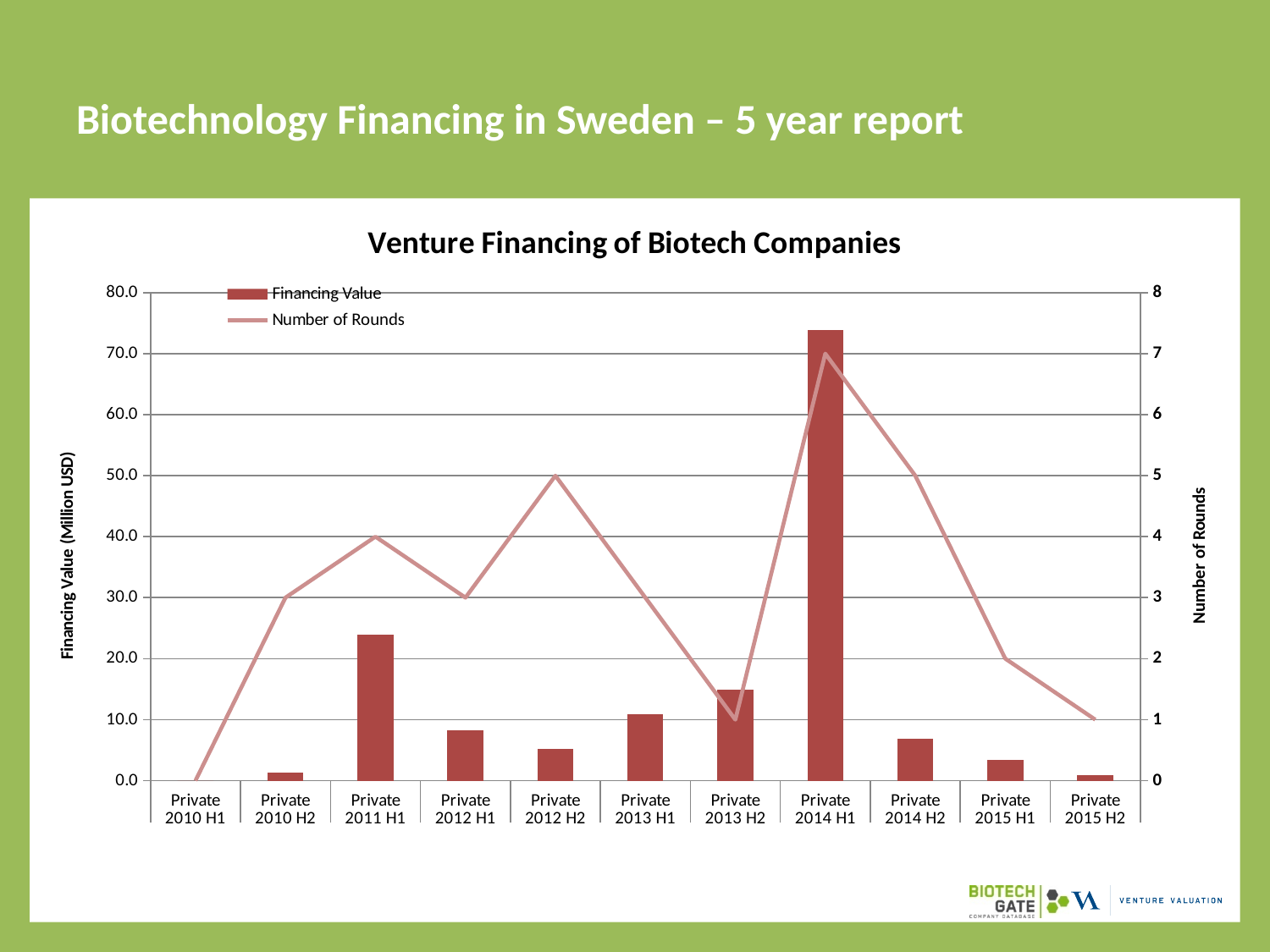
What kind of chart is shown on the slide? A combined bar and line chart Is the Financing Value for Private 2014 H1 greater or less than 70.0? greater What is the difference in Number of Rounds between Private 2014 H1 and Private 2015 H1? 5 Is the Financing Value for Private 2011 H1 greater or less than 20.0? greater What is the Number of Rounds for Private 2013 H2? 1 Which period has the highest Financing Value? Private 2014 H1 What is the Number of Rounds for Private 2014 H1? 7 What is the Number of Rounds for Private 2012 H2? 5 What is the Number of Rounds for Private 2010 H1? 0 How many series does the legend list? 2 How many periods are shown on the x axis? 11 Which is larger, the Financing Value for Private 2013 H2 or for Private 2012 H2? Private 2013 H2